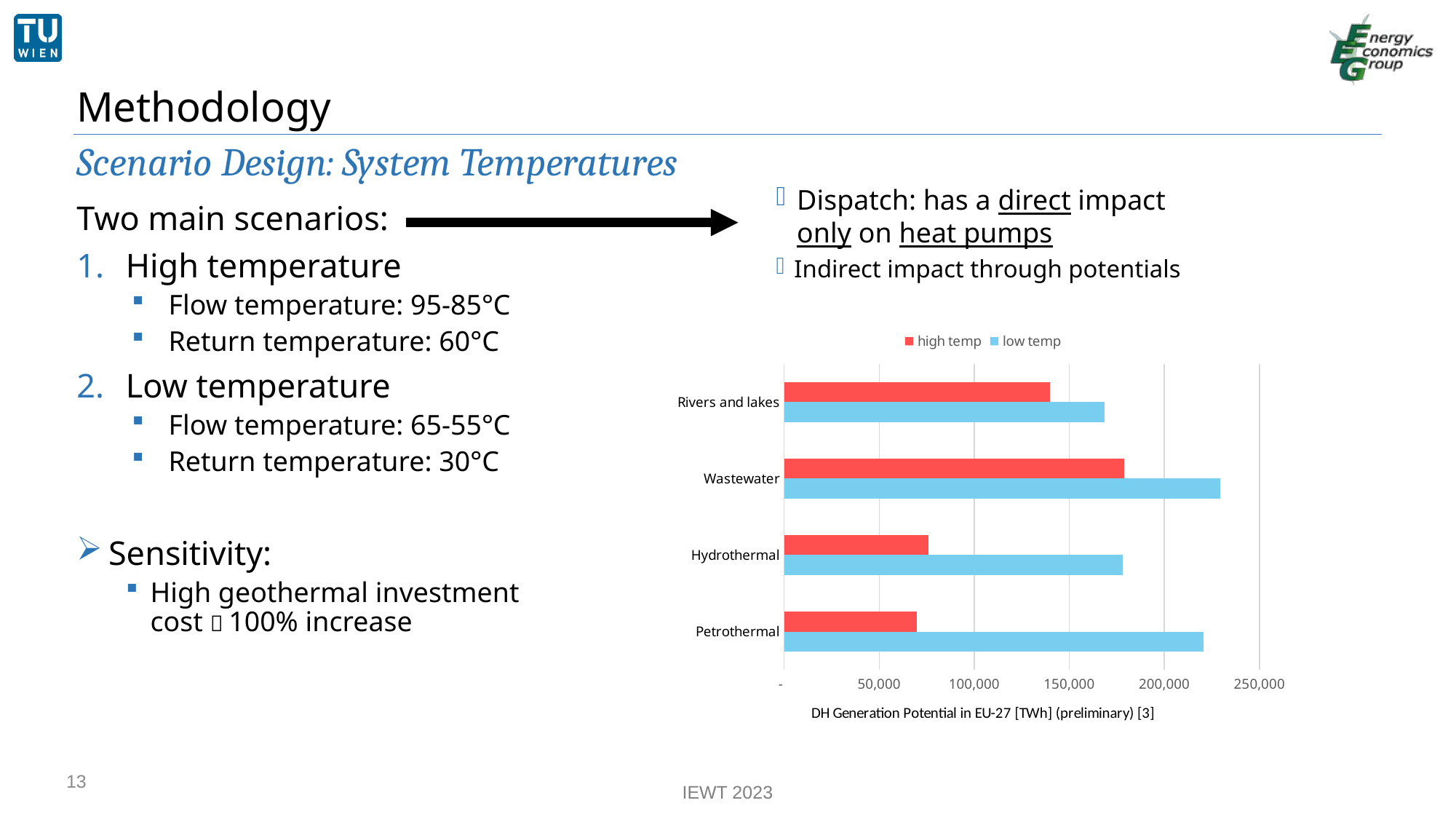
What kind of chart is shown on the slide? bar chart Is the low temp value for Wastewater greater or less than 200,000? greater Which category has the highest low temp value? Wastewater How many series does the chart legend list? 2 Is the high temp value for Hydrothermal greater or less than 50,000? greater How many categories are shown on the chart? 4 For Wastewater, which is larger: the high temp value or the low temp value? low temp Is the low temp value for Petrothermal greater or less than 200,000? greater For Hydrothermal, which is larger: the high temp value or the low temp value? low temp What is the axis title shown below the chart? DH Generation Potential in EU-27 [TWh] (preliminary) [3] Which category has the highest high temp value? Wastewater